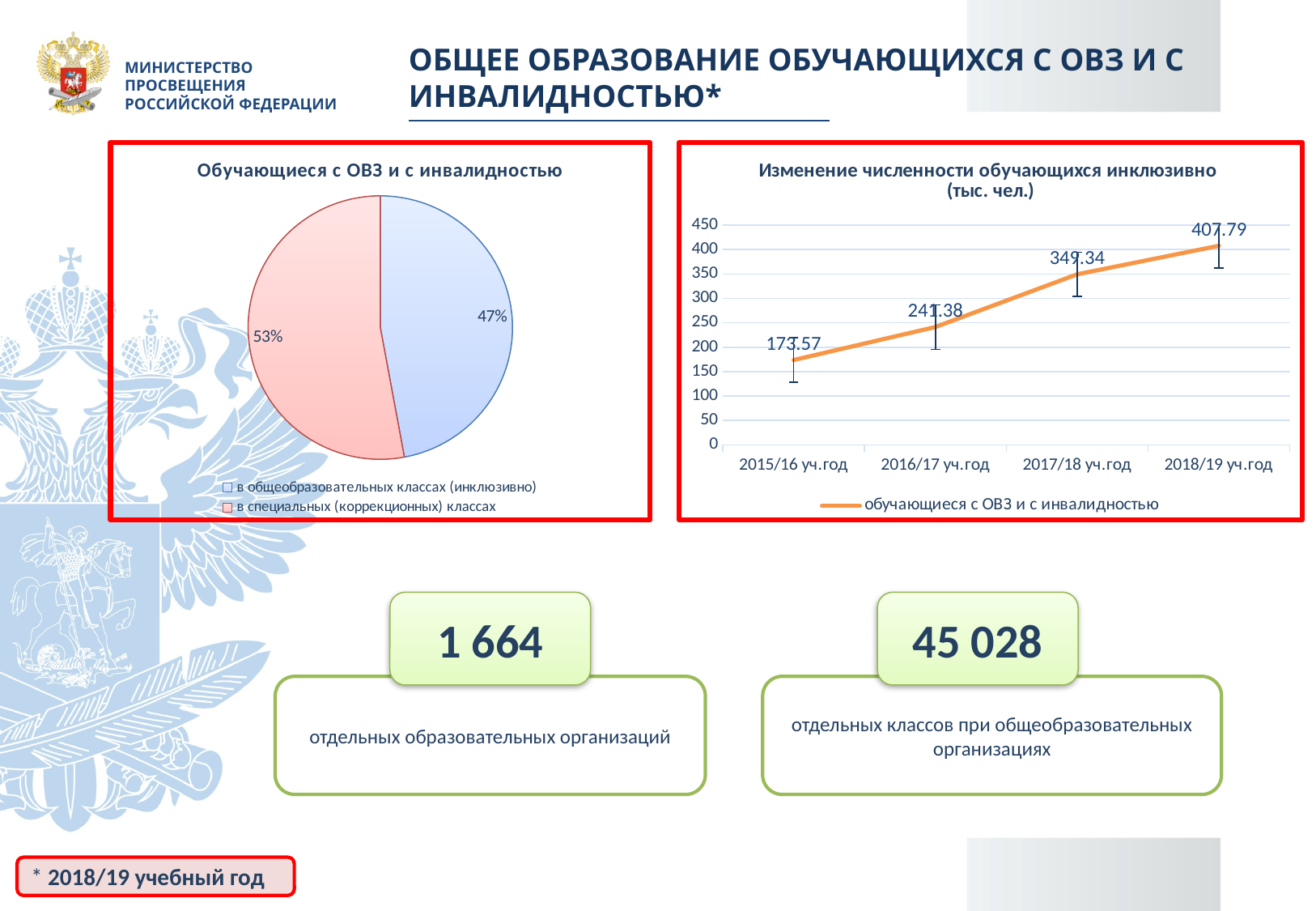
In the chart 'Изменение численности обучающихся инклюзивно (тыс. чел.)', what is the value for 2017/18 уч.год? 349.34 In the pie chart 'Обучающиеся с ОВЗ и с инвалидностью', how many slices are there? 2 What type of chart is the left chart 'Обучающиеся с ОВЗ и с инвалидностью'? pie chart What type of chart is the right chart 'Изменение численности обучающихся инклюзивно (тыс. чел.)'? line chart In the pie chart 'Обучающиеся с ОВЗ и с инвалидностью', which category has the larger share? в специальных (коррекционных) классах In the pie chart 'Обучающиеся с ОВЗ и с инвалидностью', what share is shown for 'в общеобразовательных классах (инклюзивно)'? 47% In the chart 'Изменение численности обучающихся инклюзивно (тыс. чел.)', how many data points are plotted? 4 In the chart 'Изменение численности обучающихся инклюзивно (тыс. чел.)', which year has the highest value? 2018/19 уч.год In the chart 'Изменение численности обучающихся инклюзивно (тыс. чел.)', what is the difference between the values for 2018/19 уч.год and 2015/16 уч.год? 234.22 In the pie chart 'Обучающиеся с ОВЗ и с инвалидностью', what share is shown for 'в специальных (коррекционных) классах'? 53% In the chart 'Изменение численности обучающихся инклюзивно (тыс. чел.)', do the values rise or fall from 2015/16 to 2018/19? rise In the chart 'Изменение численности обучающихся инклюзивно (тыс. чел.)', what is the value for 2015/16 уч.год? 173.57